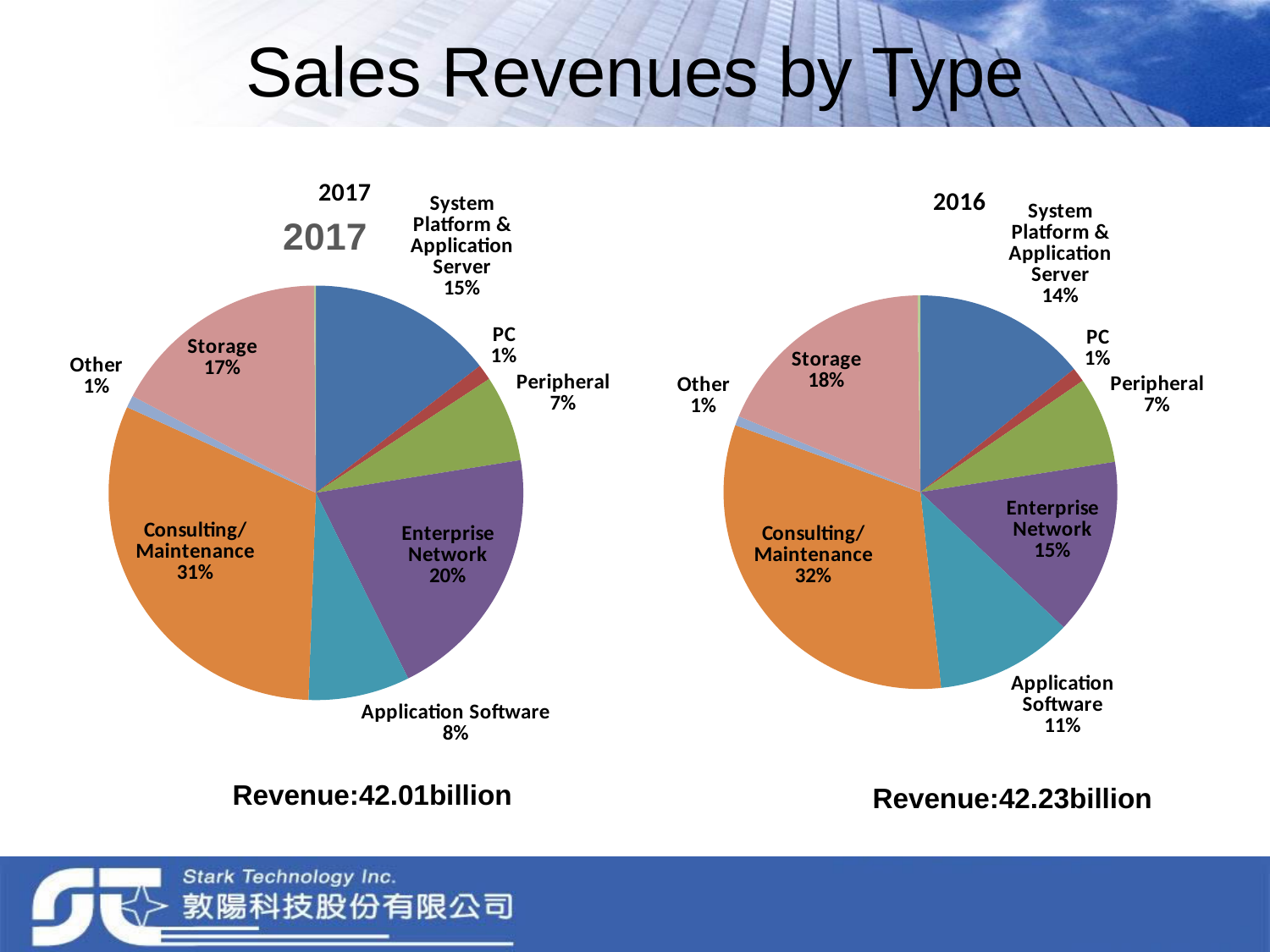
In the 2017 pie chart, which is larger: Storage or System Platform & Application Server? Storage What type of chart is used on the left side of the slide for 2017? Pie chart In the 2016 pie chart, what share does Storage have? 18% What revenue figure is printed below the 2016 pie chart? Revenue:42.23billion In the 2017 pie chart, what share does Consulting/Maintenance have? 31% In the 2016 pie chart, what share does Application Software have? 11% In the 2017 pie chart, what is the difference between the Enterprise Network share and the Application Software share? 12% In the 2017 pie chart, what share does Enterprise Network have? 20% In the 2016 pie chart, which category has the largest share? Consulting/Maintenance In the 2016 pie chart, what is the difference between the Consulting/Maintenance share and the Storage share? 14% In the 2017 pie chart, which category has the largest share? Consulting/Maintenance